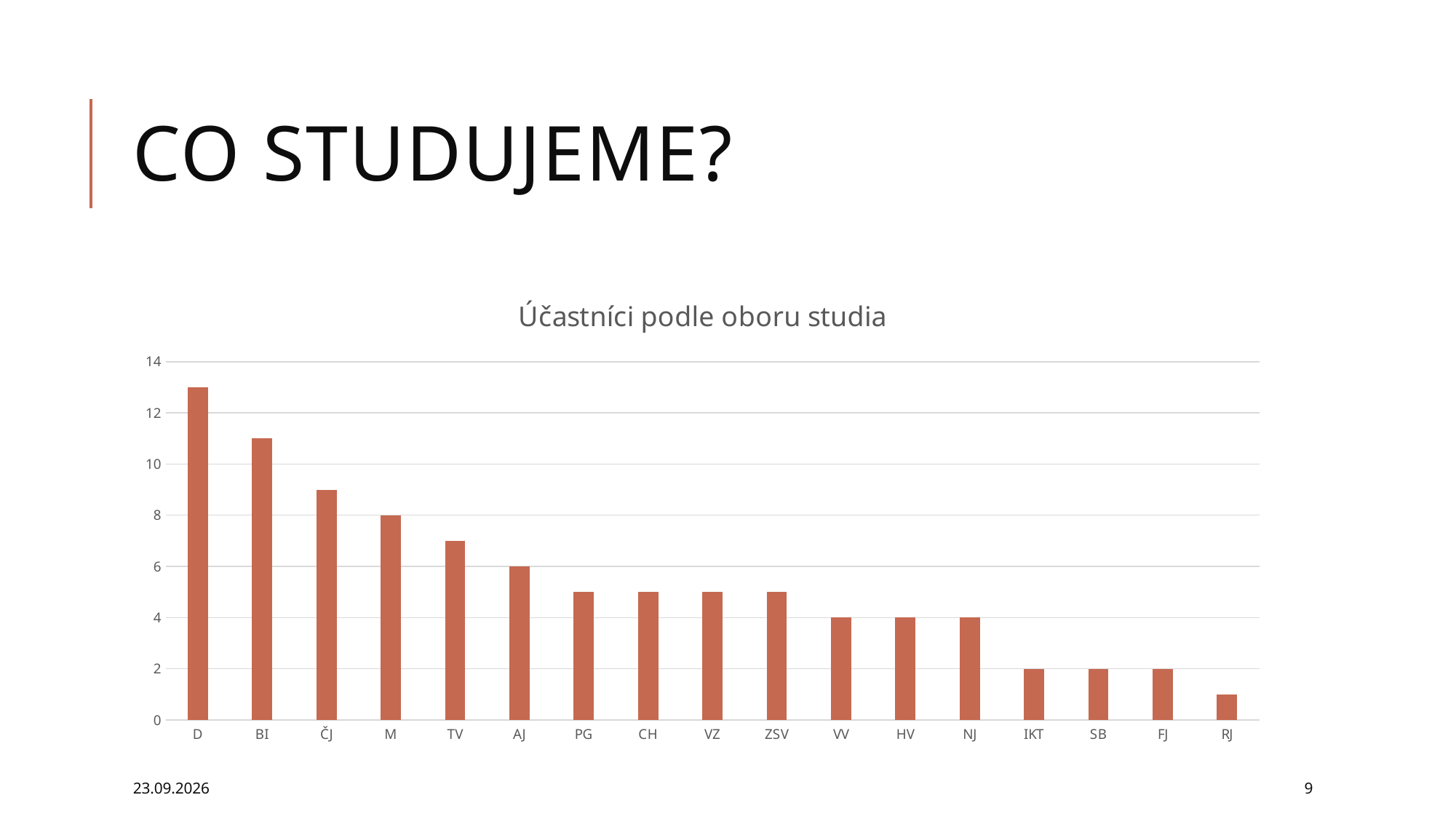
What is the value for NJ? 4 What is the value for FJ? 2 Which category has the lowest value? RJ Is the value for ČJ greater or less than 10? less Is the value for D greater or less than 12? greater Do the values rise or fall from left to right along the x axis? fall What kind of chart is shown on the slide? bar chart Which category has the highest value? D What is the title of the chart? Účastníci podle oboru studia What is the value for M? 8 What is the value for AJ? 6 How many categories are shown on the x axis? 17